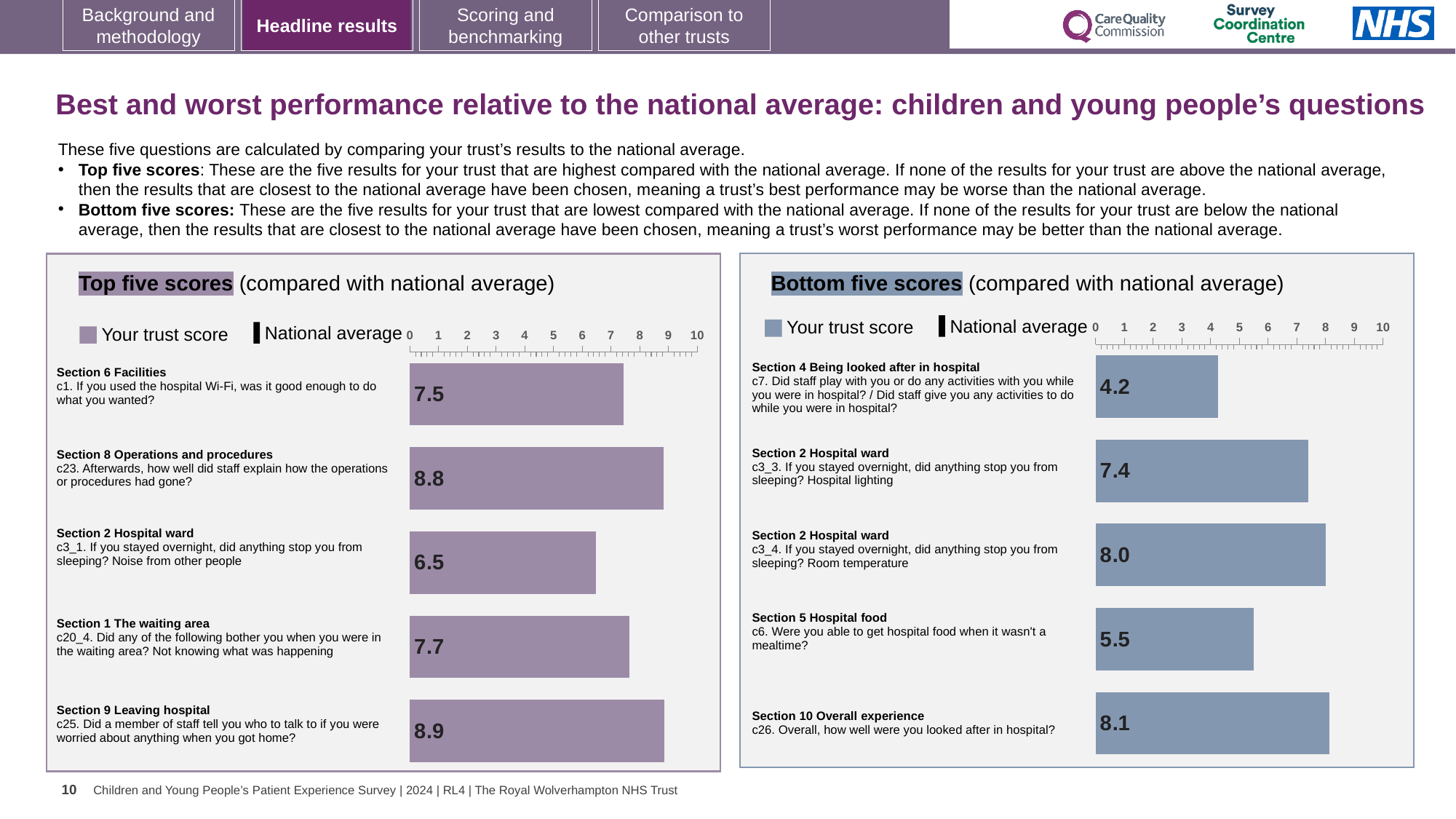
In the Bottom five scores chart, what is the difference between the trust score for c3_4 (room temperature) and c6 (hospital food when it wasn't a mealtime)? 2.5 What kind of chart is the Top five scores chart? Bar chart How many bars are plotted in the Top five scores chart? 5 How many series does the legend of the Bottom five scores chart list? 2 In the Top five scores chart, what is the trust score for c1 (If you used the hospital Wi-Fi, was it good enough to do what you wanted?)? 7.5 In the Top five scores chart, which question has the highest trust score? c25. Did a member of staff tell you who to talk to if you were worried about anything when you got home? (Section 9 Leaving hospital) In the Bottom five scores chart, what is the trust score for c26 (Overall, how well were you looked after in hospital?)? 8.1 In the Bottom five scores chart, which has the larger trust score: c3_3 (hospital lighting) or c6 (hospital food when it wasn't a mealtime)? c3_3 (hospital lighting) What are the two legend entries shown for the Top five scores chart? Your trust score and National average In the Bottom five scores chart, is the trust score for c7 (Did staff play with you or do any activities with you) greater or less than 5? less In the Top five scores chart, what is the difference between the trust score for c23 (how well did staff explain how the operations or procedures had gone) and c3_1 (noise from other people)? 2.3 In the Bottom five scores chart, which question has the lowest trust score? c7. Did staff play with you or do any activities with you while you were in hospital? (Section 4 Being looked after in hospital)